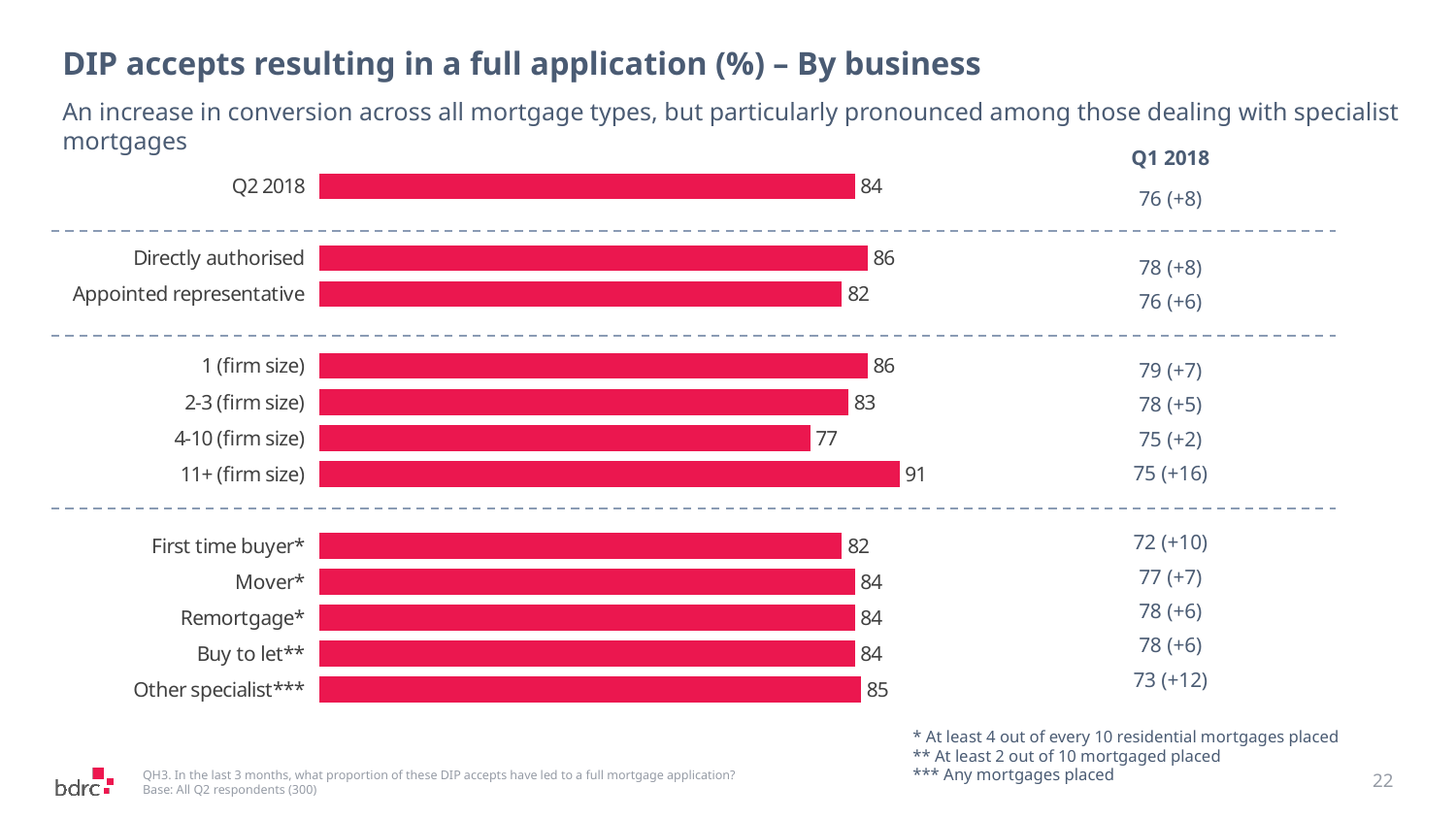
Which is larger, the value for Directly authorised or the value for Appointed representative? Directly authorised What is the difference between the values for 11+ (firm size) and 4-10 (firm size)? 14 What is the value for Other specialist***? 85 What kind of chart is shown on the slide? Bar chart What colour are the bars in the chart? Red What is the value for Appointed representative? 82 What is the value for 11+ (firm size)? 91 What is the difference between the Q2 2018 value for 1 (firm size) and 2-3 (firm size)? 3 Which category has the lowest value? 4-10 (firm size) What is the Q1 2018 value shown for First time buyer*? 72 (+10) Which category has the highest value? 11+ (firm size) How many categories are plotted in the chart? 12